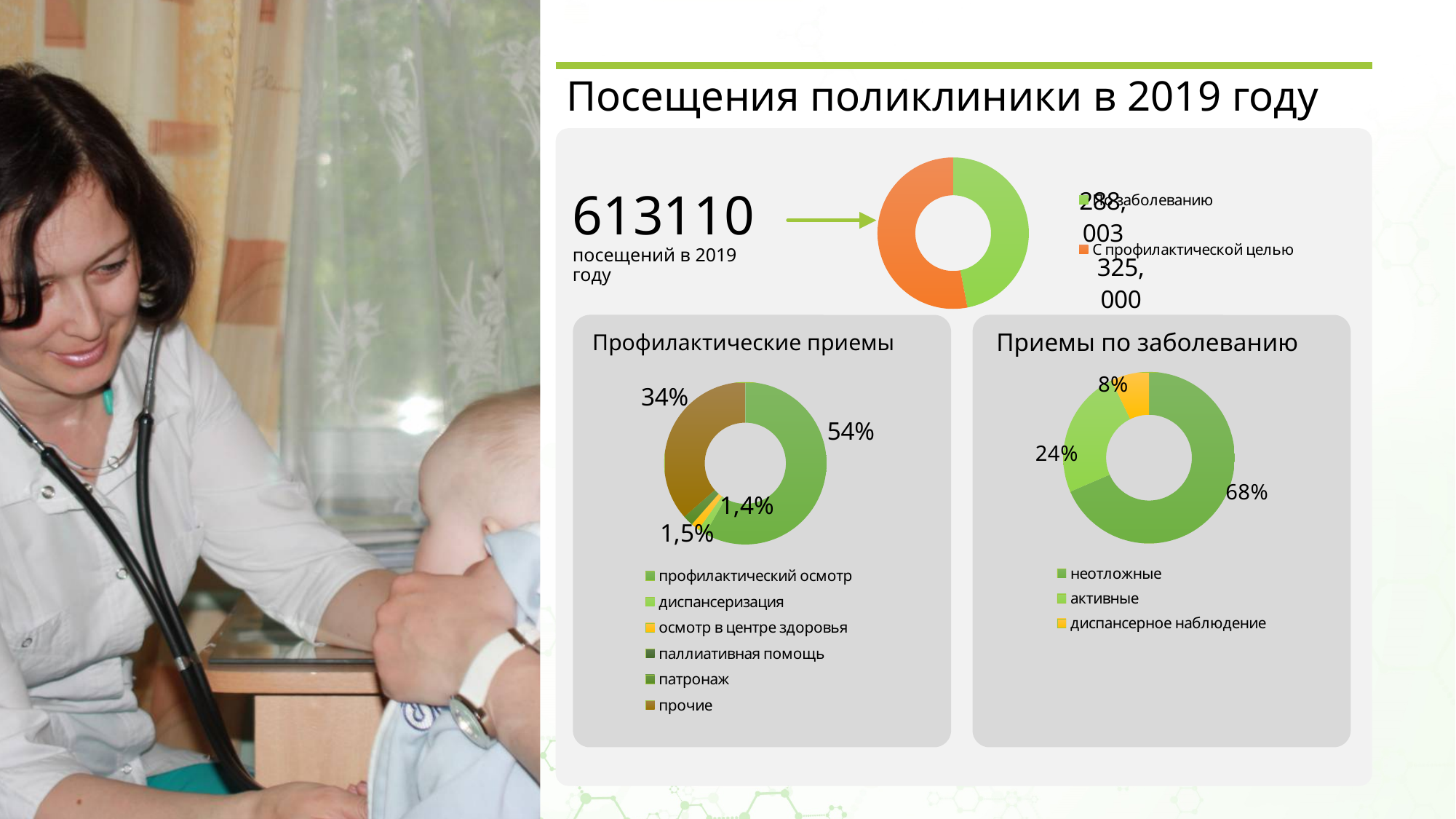
In the chart titled 'Приемы по заболеванию', what percentage is shown for 'диспансерное наблюдение'? 8% How many categories does the legend of the chart titled 'Профилактические приемы' list? 6 How many categories does the legend of the chart titled 'Приемы по заболеванию' list? 3 What type of chart is used for 'Профилактические приемы'? Donut (pie) chart In the chart titled 'Приемы по заболеванию', which category has the smallest share? диспансерное наблюдение In the chart titled 'Профилактические приемы', what percentage is shown for 'профилактический осмотр'? 54% In the chart titled 'Профилактические приемы', which category has the largest share? профилактический осмотр In the chart titled 'Приемы по заболеванию', what is the difference in percentage points between 'неотложные' and 'активные'? 44 In the chart titled 'Приемы по заболеванию', what percentage is shown for 'неотложные'? 68% In the chart titled 'Приемы по заболеванию', what percentage is shown for 'активные'? 24% In the chart titled 'Профилактические приемы', what percentage is shown for 'прочие'? 34% In the chart titled 'Приемы по заболеванию', which category has the largest share? неотложные